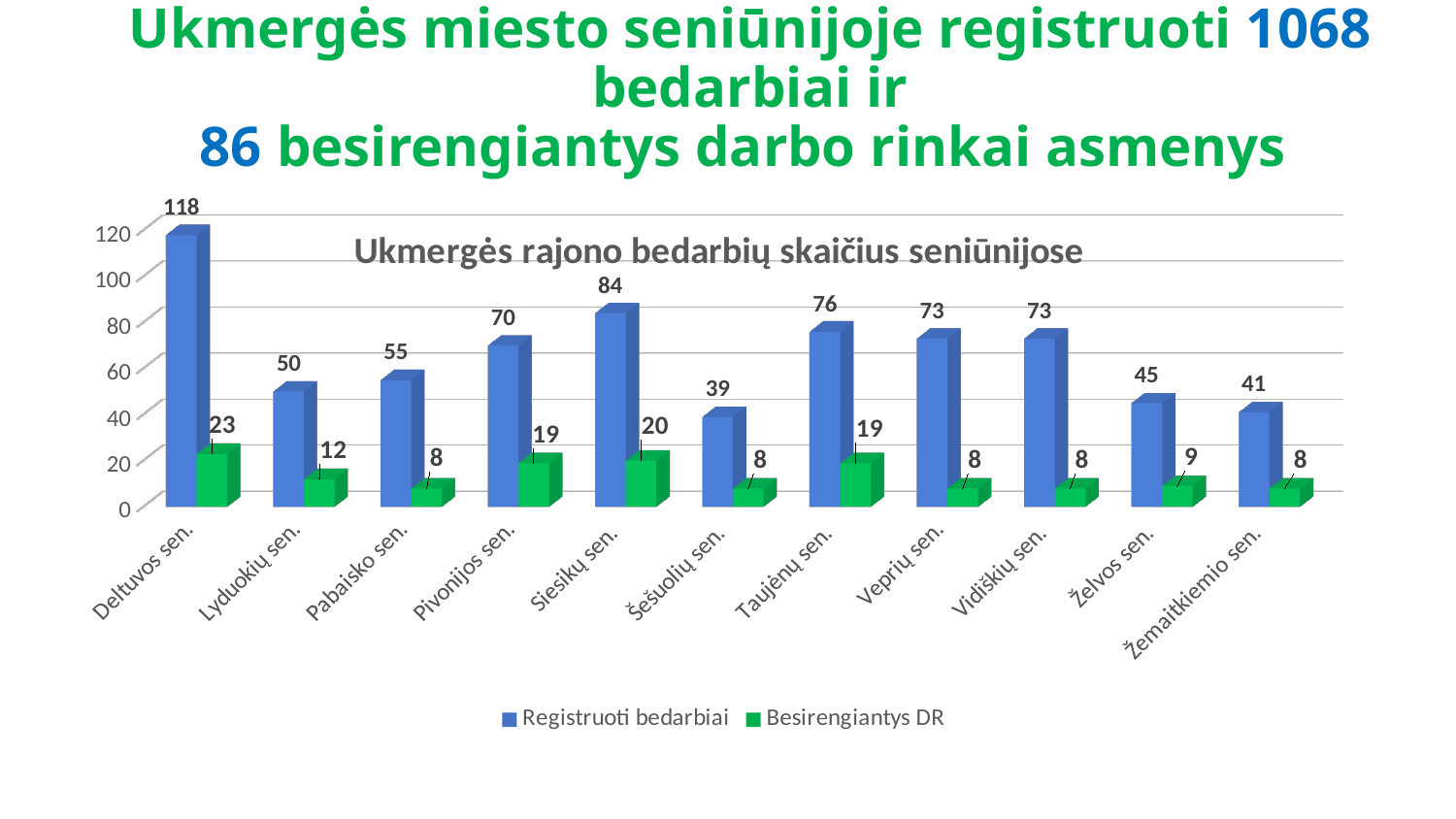
What is the title of the chart? Ukmergės rajono bedarbių skaičius seniūnijose How many categories are shown on the x axis? 11 Which category has the lowest value for Registruoti bedarbiai? Šešuolių sen. What is the value of Registruoti bedarbiai for Šešuolių sen.? 39 Which category has the highest value for Besirengiantys DR? Deltuvos sen. What kind of chart is shown on the slide? Bar chart How many series does the legend list? 2 What is the value of Registruoti bedarbiai for Deltuvos sen.? 118 Which category has the highest value for Registruoti bedarbiai? Deltuvos sen. Which is larger: Registruoti bedarbiai for Taujėnų sen. or for Pivonijos sen.? Taujėnų sen. What is the difference between Registruoti bedarbiai and Besirengiantys DR for Siesikų sen.? 64 What is the value of Besirengiantys DR for Pivonijos sen.? 19